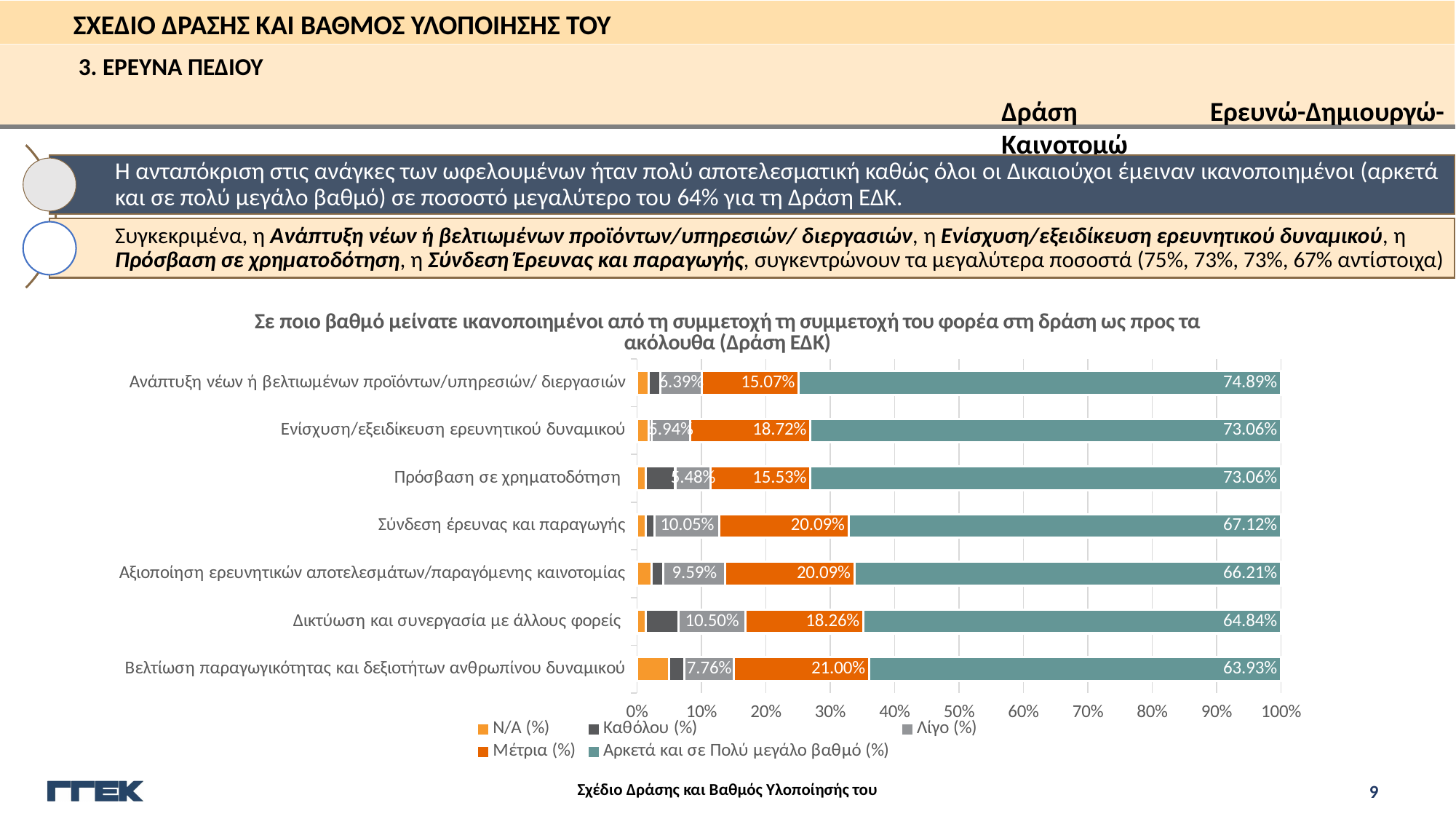
Which category has the highest 'Αρκετά και σε Πολύ μεγάλο βαθμό (%)' value? Ανάπτυξη νέων ή βελτιωμένων προϊόντων/υπηρεσιών/ διεργασιών What is the 'Μέτρια (%)' value for 'Βελτίωση παραγωγικότητας και δεξιοτήτων ανθρωπίνου δυναμικού'? 21.00% What is the 'Αρκετά και σε Πολύ μεγάλο βαθμό (%)' value for 'Ανάπτυξη νέων ή βελτιωμένων προϊόντων/υπηρεσιών/ διεργασιών'? 74.89% Which category has the lowest 'Αρκετά και σε Πολύ μεγάλο βαθμό (%)' value? Βελτίωση παραγωγικότητας και δεξιοτήτων ανθρωπίνου δυναμικού What is the 'Λίγο (%)' value for 'Δικτύωση και συνεργασία με άλλους φορείς'? 10.50% What is the difference between the 'Αρκετά και σε Πολύ μεγάλο βαθμό (%)' values for 'Σύνδεση έρευνας και παραγωγής' and 'Αξιοποίηση ερευνητικών αποτελεσμάτων/παραγόμενης καινοτομίας'? 0.91% What type of chart is shown on the slide? stacked bar chart How many series does the legend list? 5 How many categories are plotted on the chart? 7 Which is larger: the 'Μέτρια (%)' value for 'Ενίσχυση/εξειδίκευση ερευνητικού δυναμικού' or for 'Πρόσβαση σε χρηματοδότηση'? Ενίσχυση/εξειδίκευση ερευνητικού δυναμικού Which series is shown in teal on the chart? Αρκετά και σε Πολύ μεγάλο βαθμό (%) What is the 'Μέτρια (%)' value for 'Σύνδεση έρευνας και παραγωγής'? 20.09%